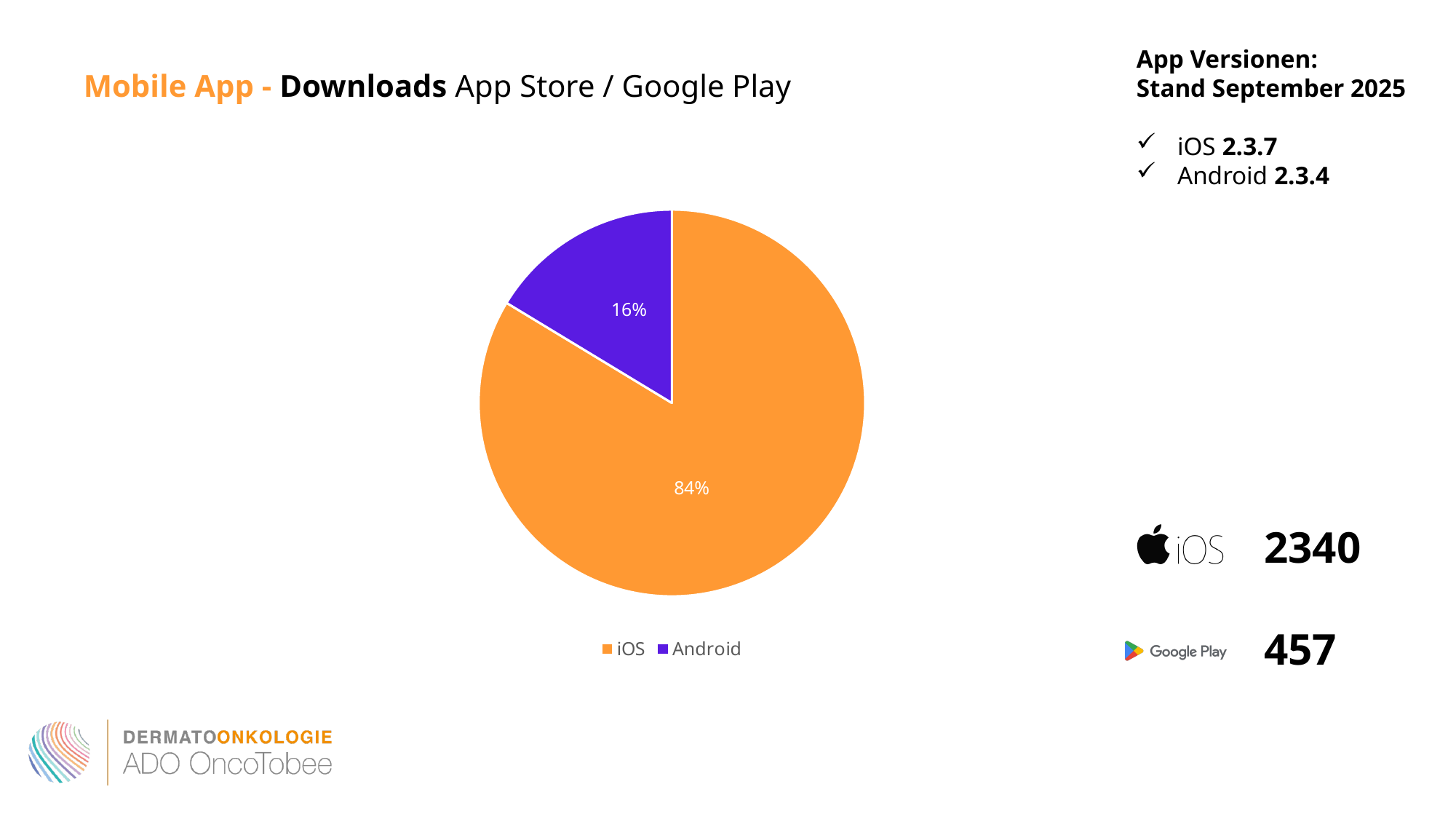
What colour is the Android slice of the pie? Purple Which slice is larger, iOS or Android? iOS Which category has the largest slice of the pie? iOS How many categories does the pie chart show? 2 What share of the pie does iOS account for? 84% What kind of chart is shown on the slide? Pie chart Which category has the smallest slice of the pie? Android What colour is the iOS slice of the pie? Orange How many entries does the legend list? 2 What is the difference in percentage points between the iOS and Android slices? 68 percentage points What share of the pie does Android account for? 16% Is the share for Android greater or less than 50%? less